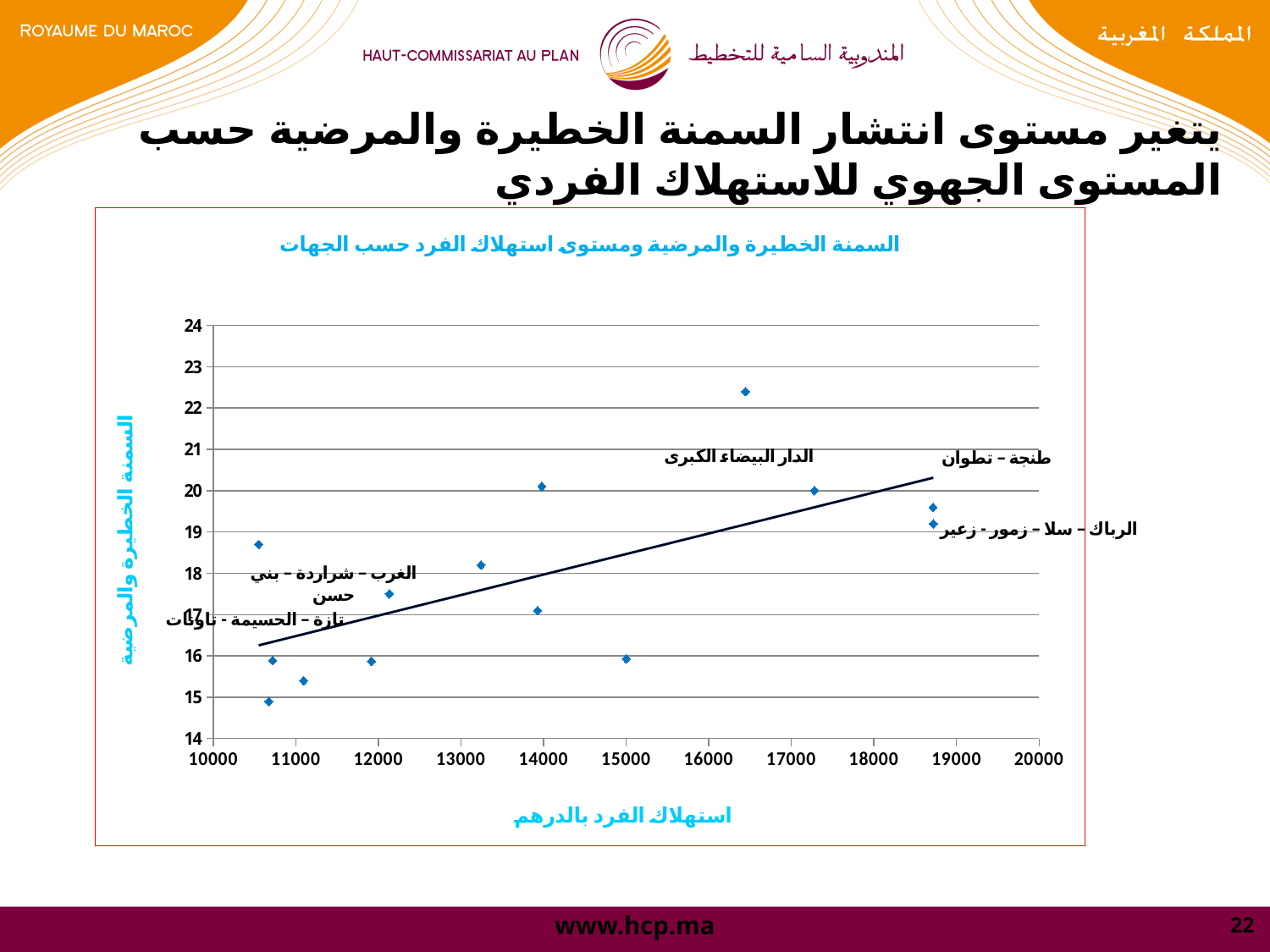
What is the title of the x axis of the chart? استهلاك الفرد بالدرهم Does the trend line in the chart rise or fall as per-capita consumption increases along the x axis? rises Is the lowest plotted point in the chart greater or less than 16 on the y axis? less What kind of chart is shown on the slide? scatter chart Which has the higher y value: the point plotted near 16000 on the x axis or the point plotted near 17000? the point near 16000 Is the y value of the point plotted near 17000 on the x axis greater or less than 19? greater What is the title of the chart? السمنة الخطيرة والمرضية ومستوى استهلاك الفرد حسب الجهات Is the point with the largest x value in the chart greater or less than 18000 on the x axis? greater